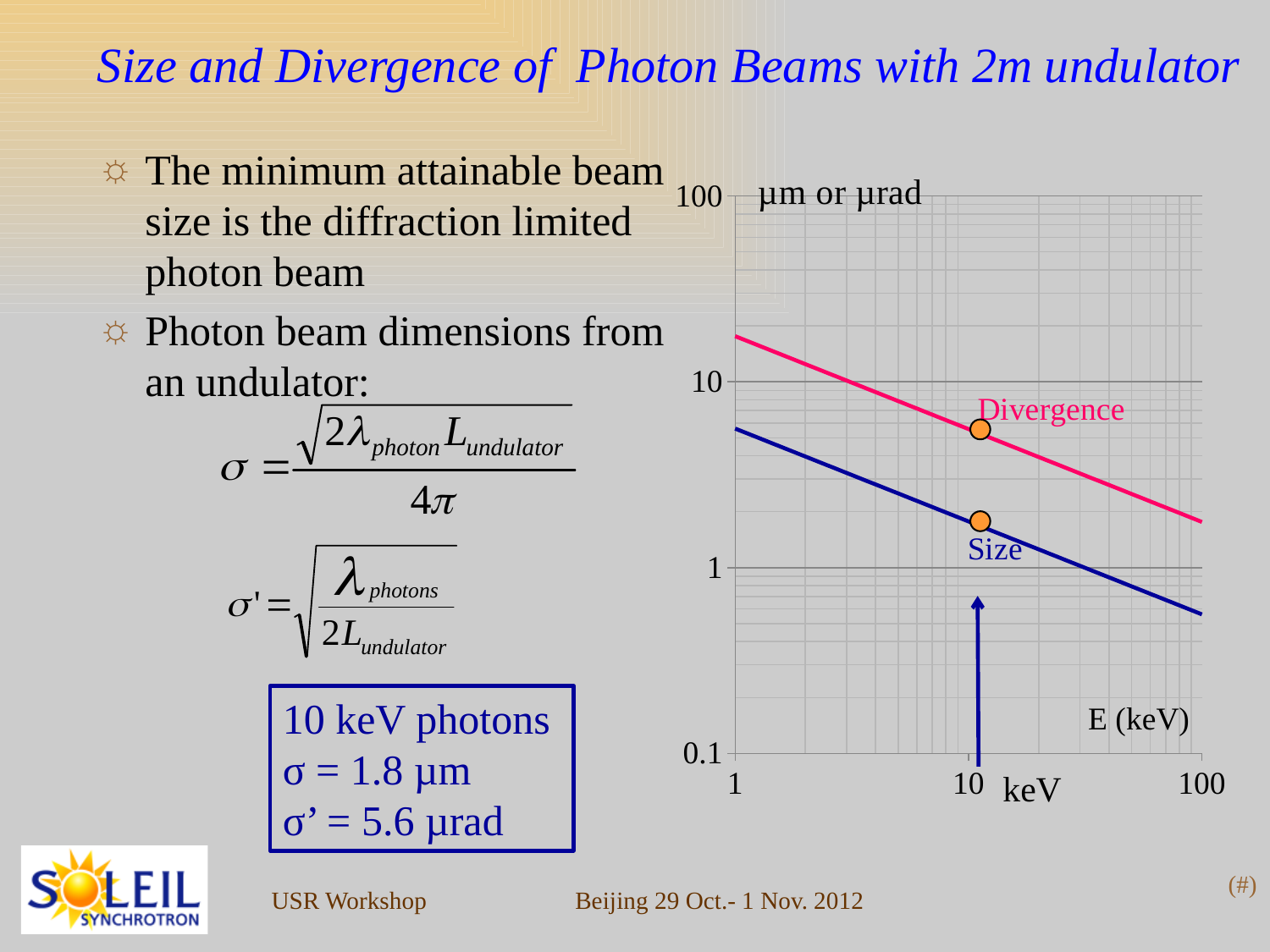
Is the Divergence value at 100 keV greater or less than 1? greater How many lines are plotted on the chart? 2 Is the Size value at 100 keV greater or less than 1? less At 10 keV, which is larger, the Divergence value or the Size value? Divergence Which line is drawn in pink, Divergence or Size? Divergence What is the label of the x axis of the chart? E (keV) Do the Size and Divergence values rise or fall as the photon energy increases? fall What is the beam divergence (σ') at 10 keV according to the slide? 5.6 µrad What is the beam size (σ) at 10 keV according to the slide? 1.8 µm What kind of chart is shown on the slide? line chart Is the Divergence value at 1 keV greater or less than 10? greater